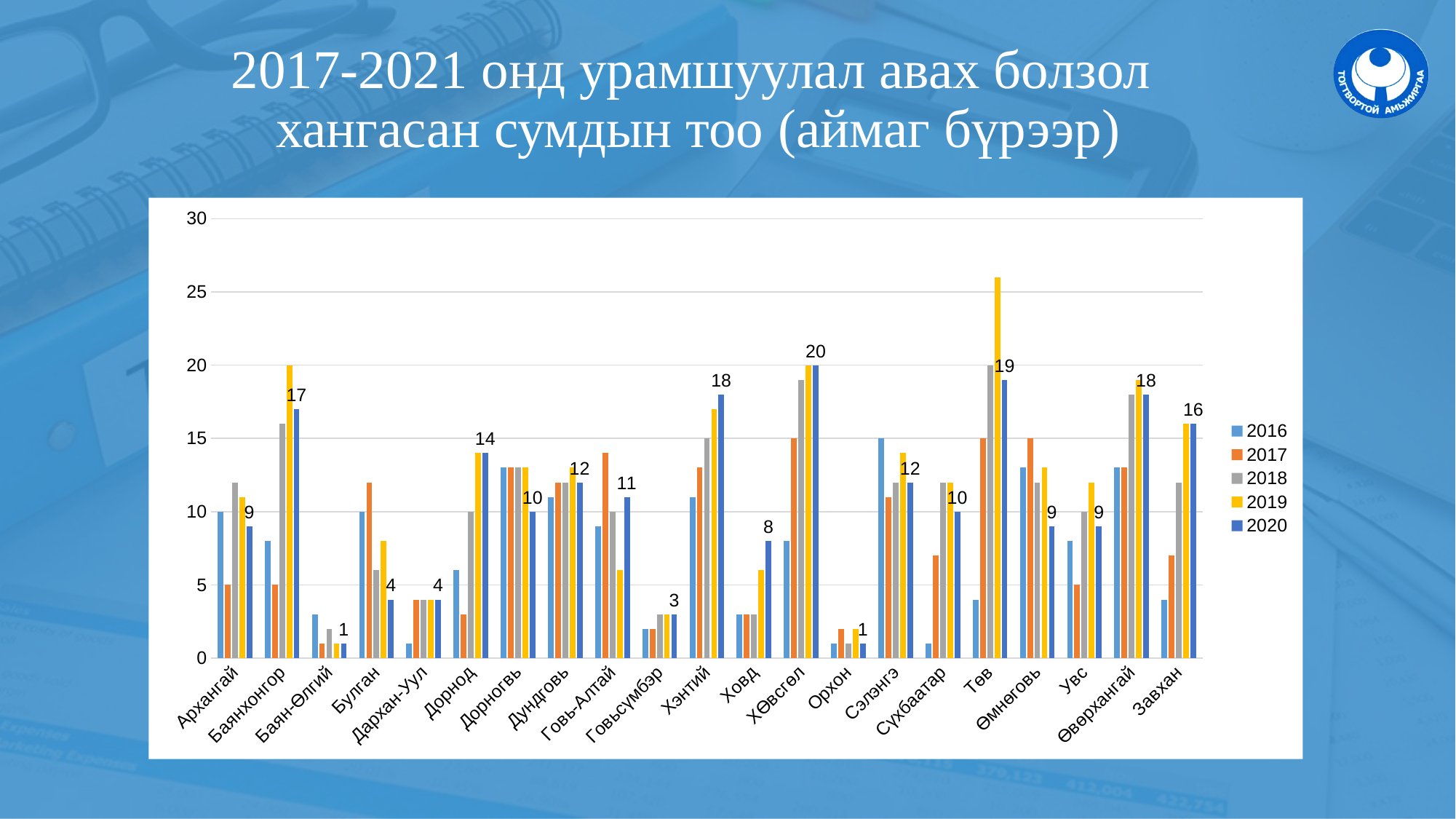
How many series does the legend list? 5 Which aimag has the highest 2020 value? Хөвсгөл What is the 2020 value for Хөвсгөл? 20 What kind of chart is shown on the slide? bar chart What is the 2020 value for Говьсүмбэр? 3 Which year's series is shown in yellow in the legend? 2019 What is the difference between the 2020 values for Хөвсгөл and Архангай? 11 Is the 2019 value for Төв greater or less than 25? greater What is the 2020 value for Баянхонгор? 17 Which has the larger 2020 value, Төв or Завхан? Төв Is the 2016 value for Сэлэнгэ greater or less than 10? greater How many aimag categories are shown on the x axis? 21